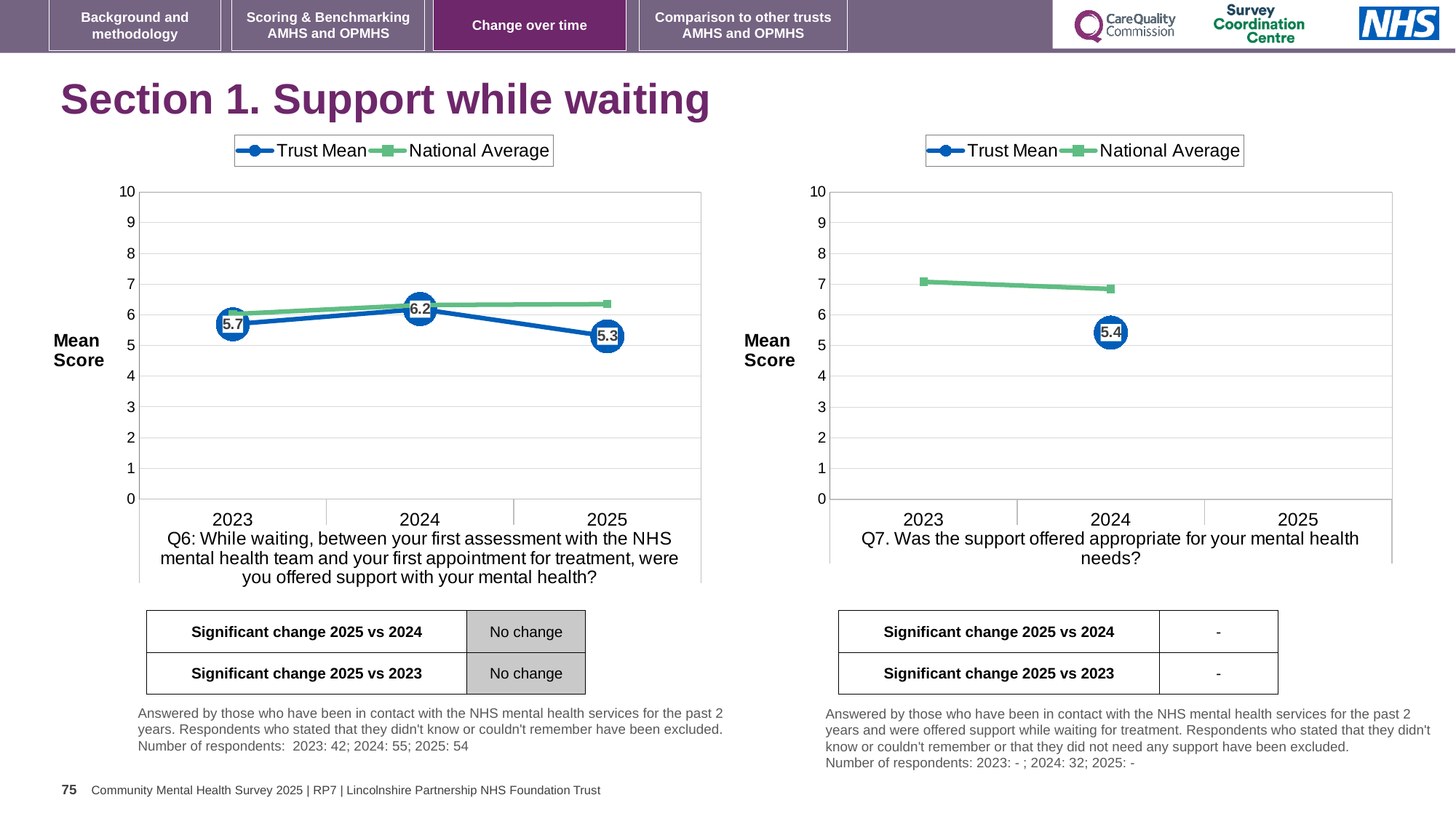
In the Q6 chart on the left, is the National Average value for 2025 greater or less than 7? less In the Q6 chart on the left, what is the difference between the Trust Mean scores for 2024 and 2025? 0.9 In the Q6 chart on the left, what is the Trust Mean score for 2025? 5.3 In the Q6 chart on the left, which year has the lowest Trust Mean score? 2025 How many series does the legend of the Q6 chart on the left list? 2 In the Q7 chart on the right, what is the Trust Mean score for 2024? 5.4 In the Q7 chart on the right, does the National Average rise or fall from 2023 to 2024? Fall In the Q7 chart on the right, is the National Average value for 2023 greater or less than 6? greater In the Q6 chart on the left, what is the Trust Mean score for 2024? 6.2 In the Q6 chart on the left, which year has the highest Trust Mean score? 2024 In the Q6 chart on the left, is the Trust Mean score for 2023 or 2024 larger? 2024 What kind of chart is the Q7 chart on the right? Line chart